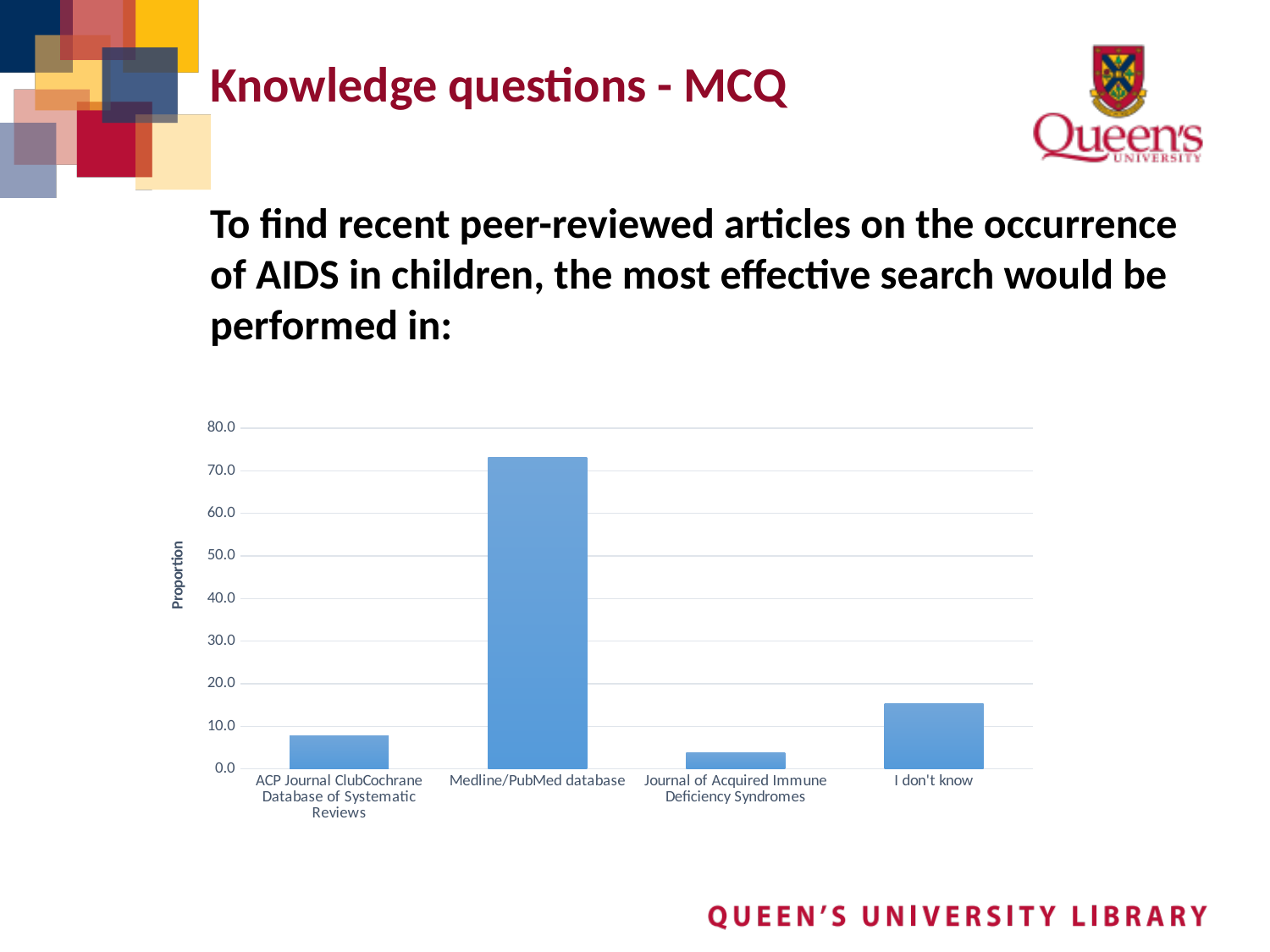
Is the value for Medline/PubMed database greater or less than 70? greater What is the label on the vertical axis of the chart? Proportion Is the value for ACP Journal Club/Cochrane Database of Systematic Reviews greater or less than 10? less Which category has the lowest proportion? Journal of Acquired Immune Deficiency Syndromes What kind of chart is shown on the slide? bar chart Is the value for I don't know greater or less than 20? less How many categories are shown on the x axis of the chart? 4 Which category has the highest proportion? Medline/PubMed database Which is larger: the value for I don't know or the value for ACP Journal Club/Cochrane Database of Systematic Reviews? I don't know What is the highest value shown on the vertical axis of the chart? 80.0